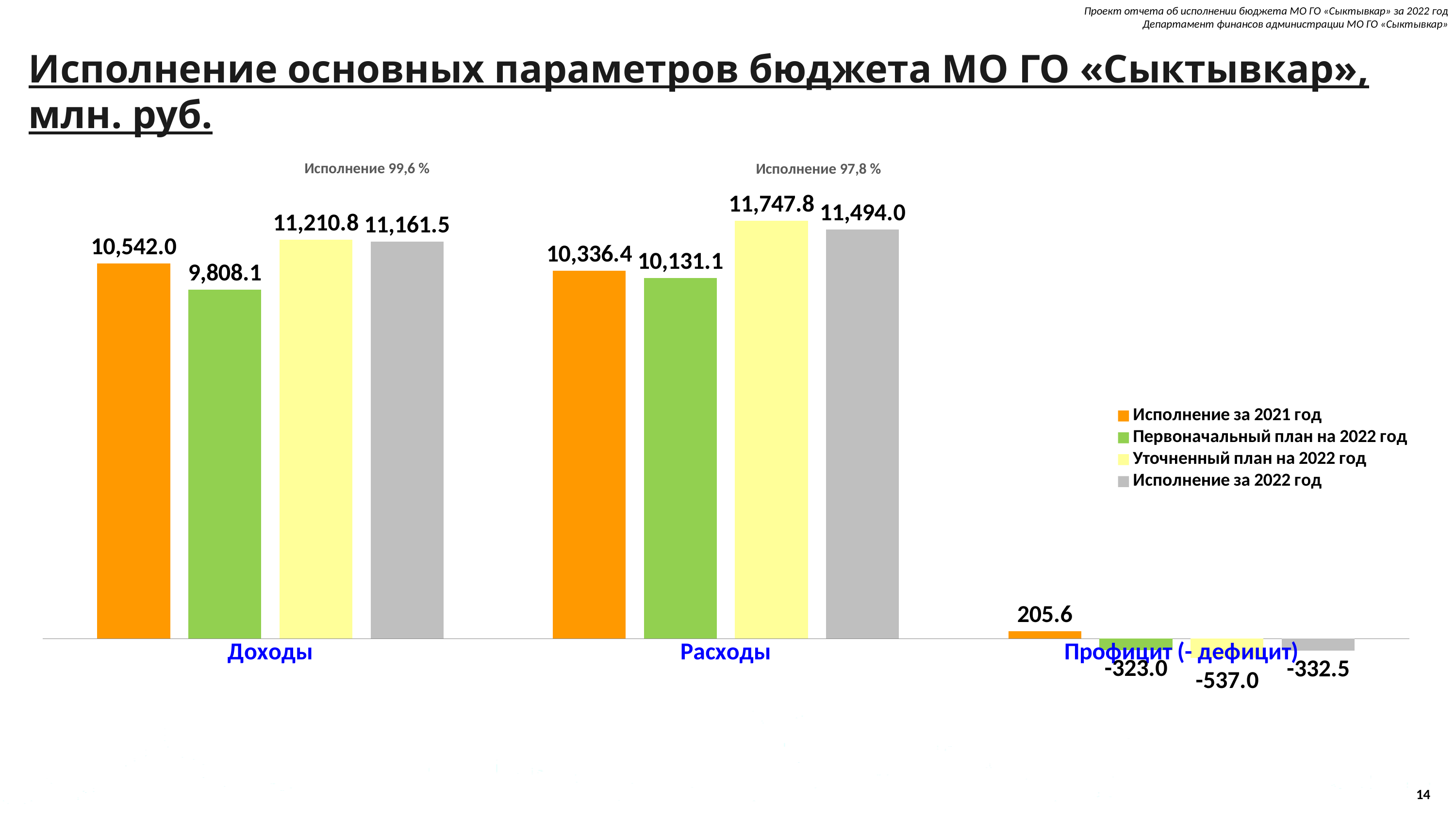
How many series does the legend list? 4 Which series has the lowest value for Доходы? Первоначальный план на 2022 год What is the value of Исполнение за 2022 год for Доходы? 11,161.5 What execution percentage (Исполнение) is shown above the Доходы group? 99,6 % What is the difference between Уточненный план на 2022 год and Исполнение за 2022 год for Расходы? 253.8 Which is larger: Исполнение за 2021 год for Доходы or Исполнение за 2021 год for Расходы? Доходы What kind of chart is shown on the slide? Bar chart What is the value of Исполнение за 2021 год for Профицит (- дефицит)? 205.6 What is the value of Первоначальный план на 2022 год for Профицит (- дефицит)? -323.0 What is the value of Уточненный план на 2022 год for Расходы? 11,747.8 How many categories are shown on the x axis? 3 Which series has the highest value for Расходы? Уточненный план на 2022 год